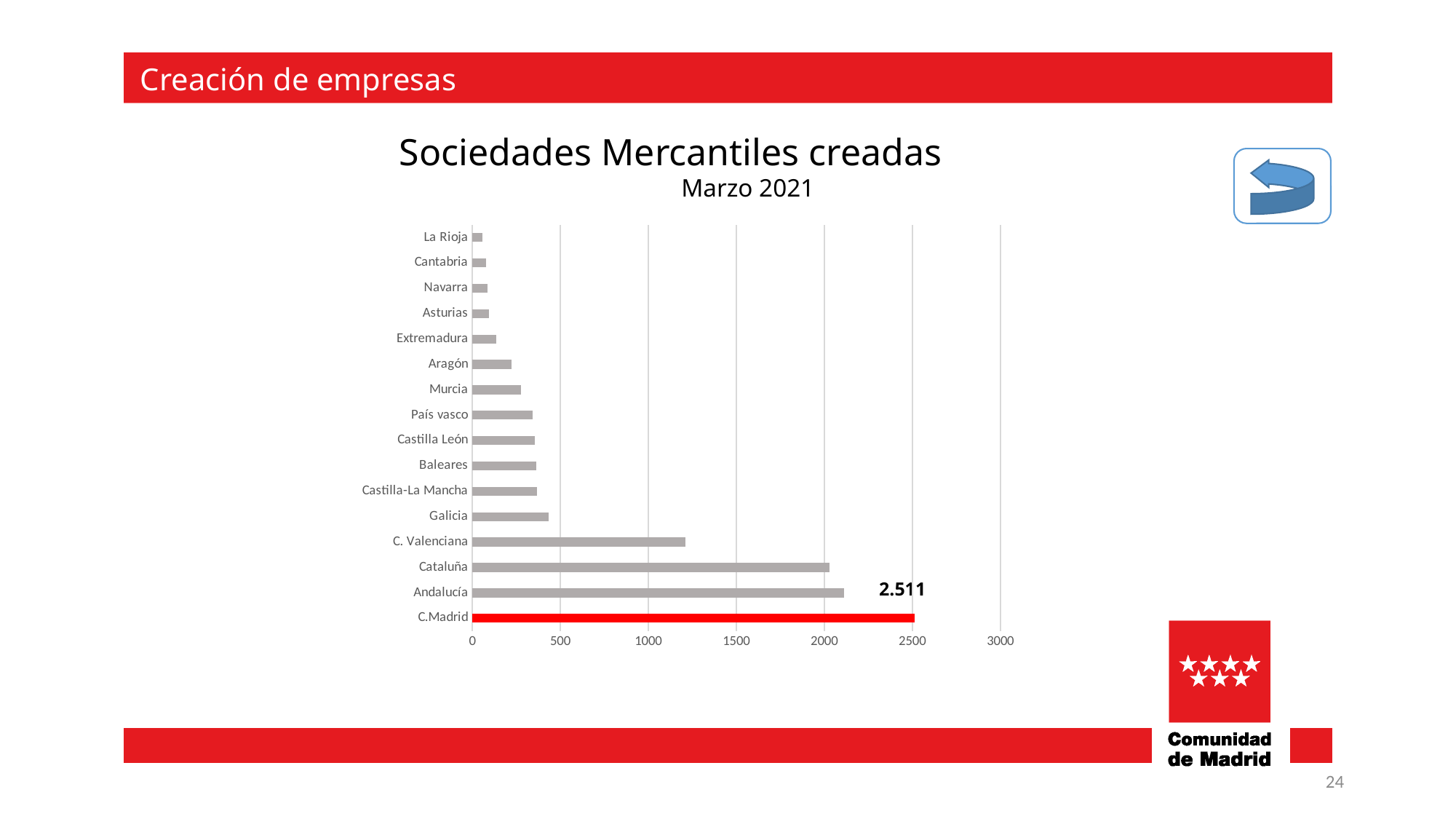
Is the value for Andalucía greater or less than 2000? greater Is the value for Galicia greater or less than 500? less Is the value for Cataluña greater or less than 2500? less What colour is the bar for C.Madrid in the chart? red Which region has the highest number of sociedades mercantiles creadas in the chart? C.Madrid How many regions are shown in the chart? 16 What value is shown for C.Madrid in the Sociedades Mercantiles creadas chart? 2.511 Which region has the lowest number of sociedades mercantiles creadas in the chart? La Rioja Which has a larger value in the chart, C. Valenciana or Galicia? C. Valenciana Which has a larger value in the chart, Andalucía or Cataluña? Andalucía What kind of chart is shown on the slide? bar chart